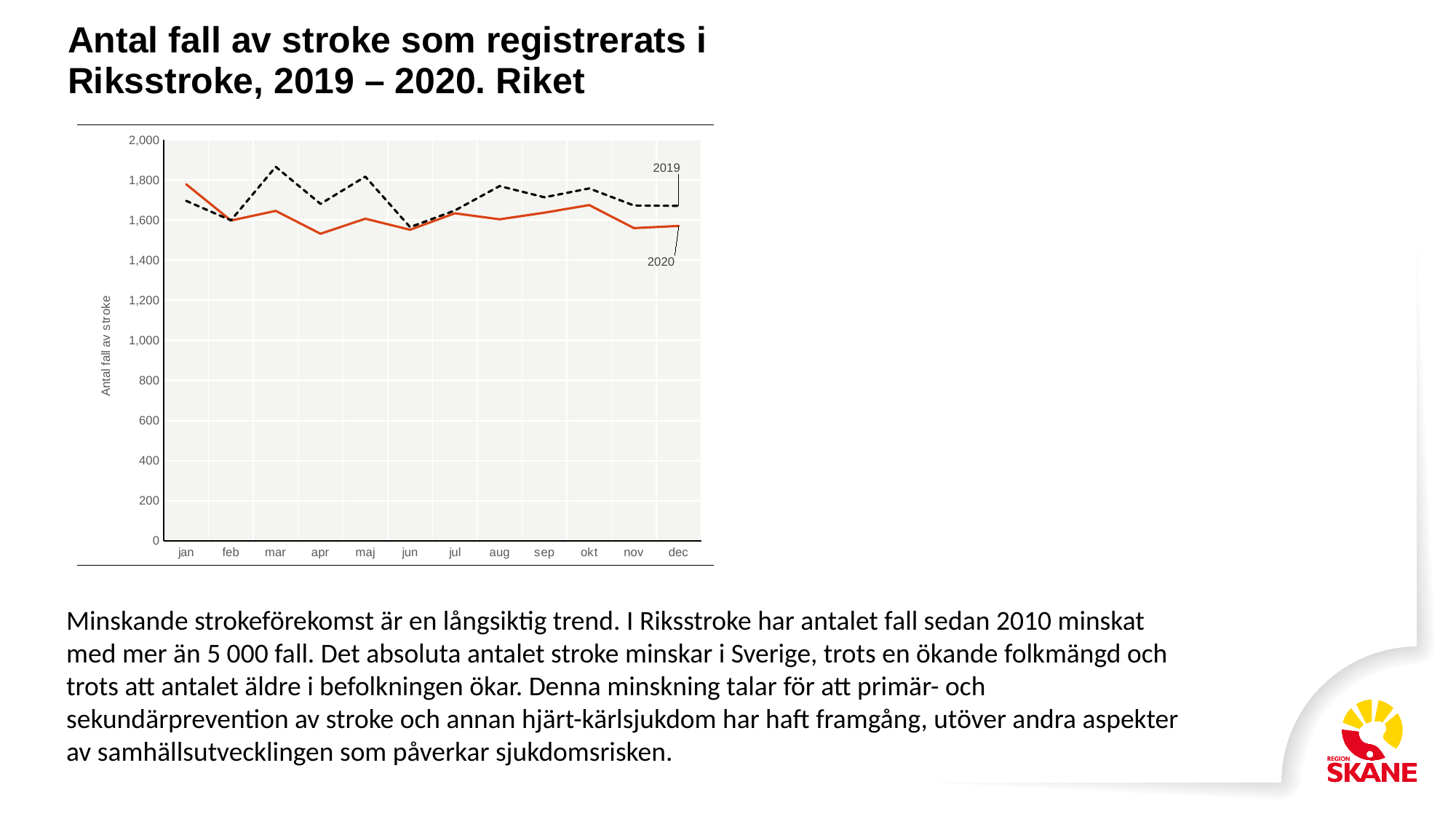
In which month does the 2020 series reach its highest value? jan In which month does the 2019 series reach its highest value? mar Is the value for 2019 in mar greater or less than 1,800? greater Is the value for 2020 in apr greater or less than 1,600? less How many series does the chart show? 2 Which series has the higher value in jan, 2019 or 2020? 2020 What kind of chart is shown on the slide? Line chart Is the value for 2019 in aug greater or less than 1,600? greater In which month does the 2019 series reach its lowest value? jun What is the label on the y axis of the chart? Antal fall av stroke How many months are plotted along the x axis? 12 Which series has the higher value in mar, 2019 or 2020? 2019